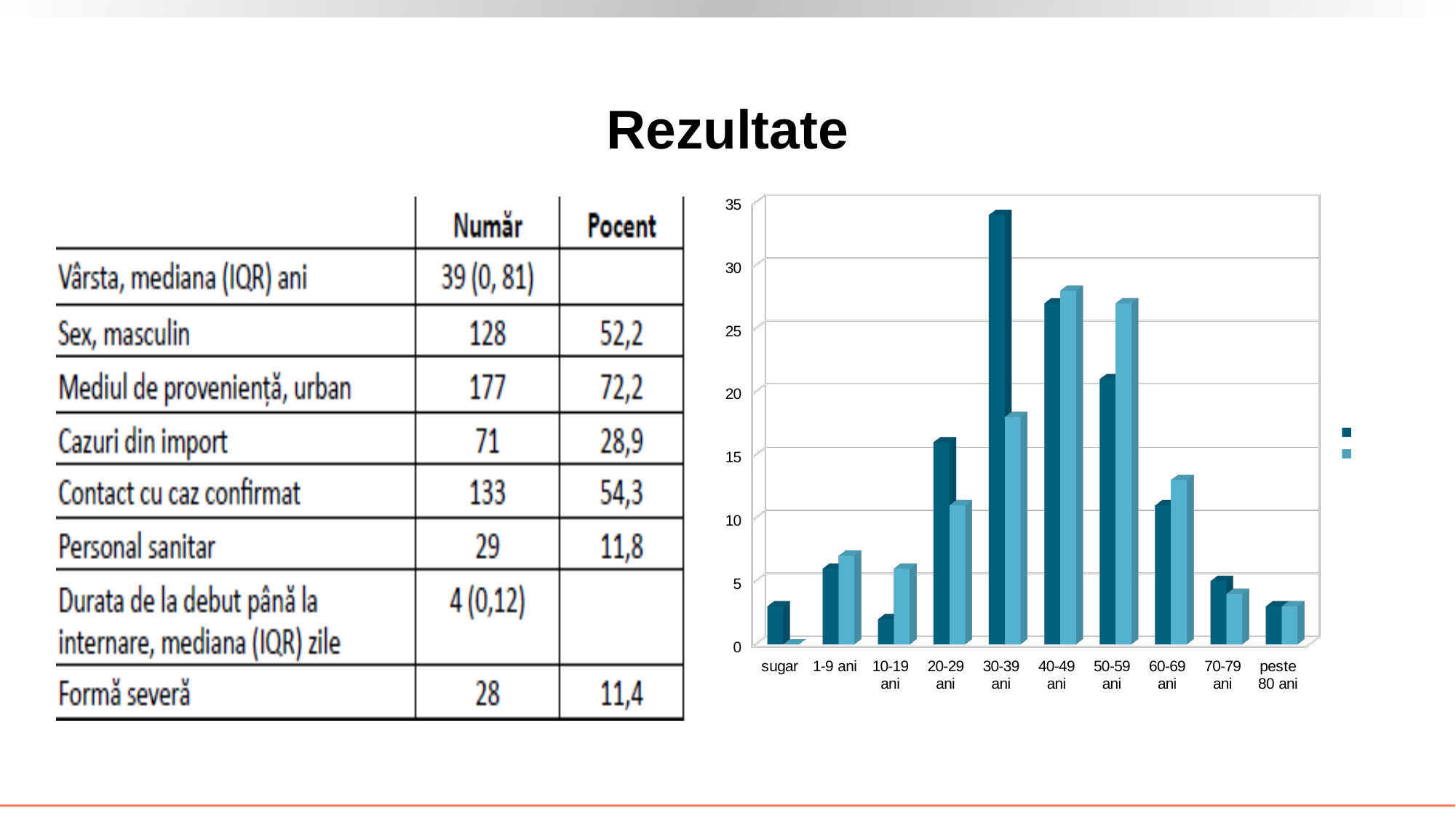
In the bar chart, for 30-39 ani, which series has the larger value, the dark blue or the light blue? dark blue In the bar chart, for 60-69 ani, which series has the larger value, the dark blue or the light blue? light blue How many series does the legend of the bar chart list? 2 How many age categories are shown on the x axis of the bar chart? 10 What is the label of the last category on the x axis of the bar chart? peste 80 ani In the bar chart, is the light blue value for 30-39 ani greater or less than 20? less What kind of chart is shown on the right of the slide? bar chart In the bar chart, is the dark blue value for 30-39 ani greater or less than 30? greater In the bar chart, which age category has the highest value for the dark blue series? 30-39 ani In the bar chart, is the light blue value for 60-69 ani greater or less than 10? greater In the bar chart, which age category has the lowest value for the light blue series? sugar